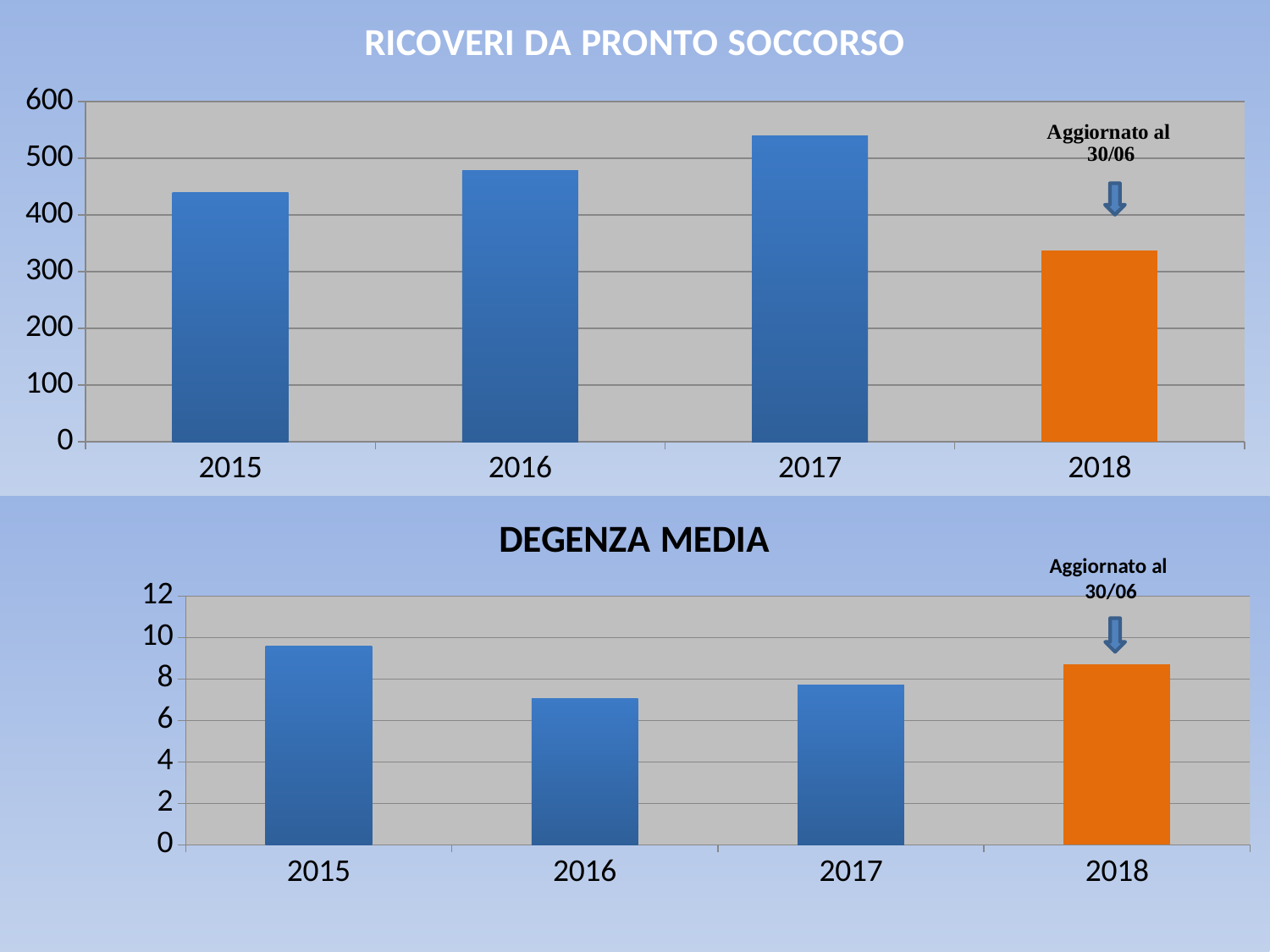
In the 'DEGENZA MEDIA' chart, is the value for 2017 larger than the value for 2016? Yes In the 'RICOVERI DA PRONTO SOCCORSO' chart, which bar is coloured orange? 2018 In the 'DEGENZA MEDIA' chart, which year has the highest value? 2015 In the 'DEGENZA MEDIA' chart, is the value for 2018 greater or less than 8? greater In the 'DEGENZA MEDIA' chart, which year has the lowest value? 2016 In the 'RICOVERI DA PRONTO SOCCORSO' chart, is the value for 2016 larger than the value for 2015? Yes In the 'RICOVERI DA PRONTO SOCCORSO' chart, is the value for 2018 greater or less than 400? less In the 'RICOVERI DA PRONTO SOCCORSO' chart, is the value for 2017 greater or less than 500? greater In the 'RICOVERI DA PRONTO SOCCORSO' chart, which year has the lowest value? 2018 What kind of chart is the 'DEGENZA MEDIA' chart? Bar chart How many years are shown in the 'RICOVERI DA PRONTO SOCCORSO' chart? 4 In the 'RICOVERI DA PRONTO SOCCORSO' chart, which year has the highest value? 2017